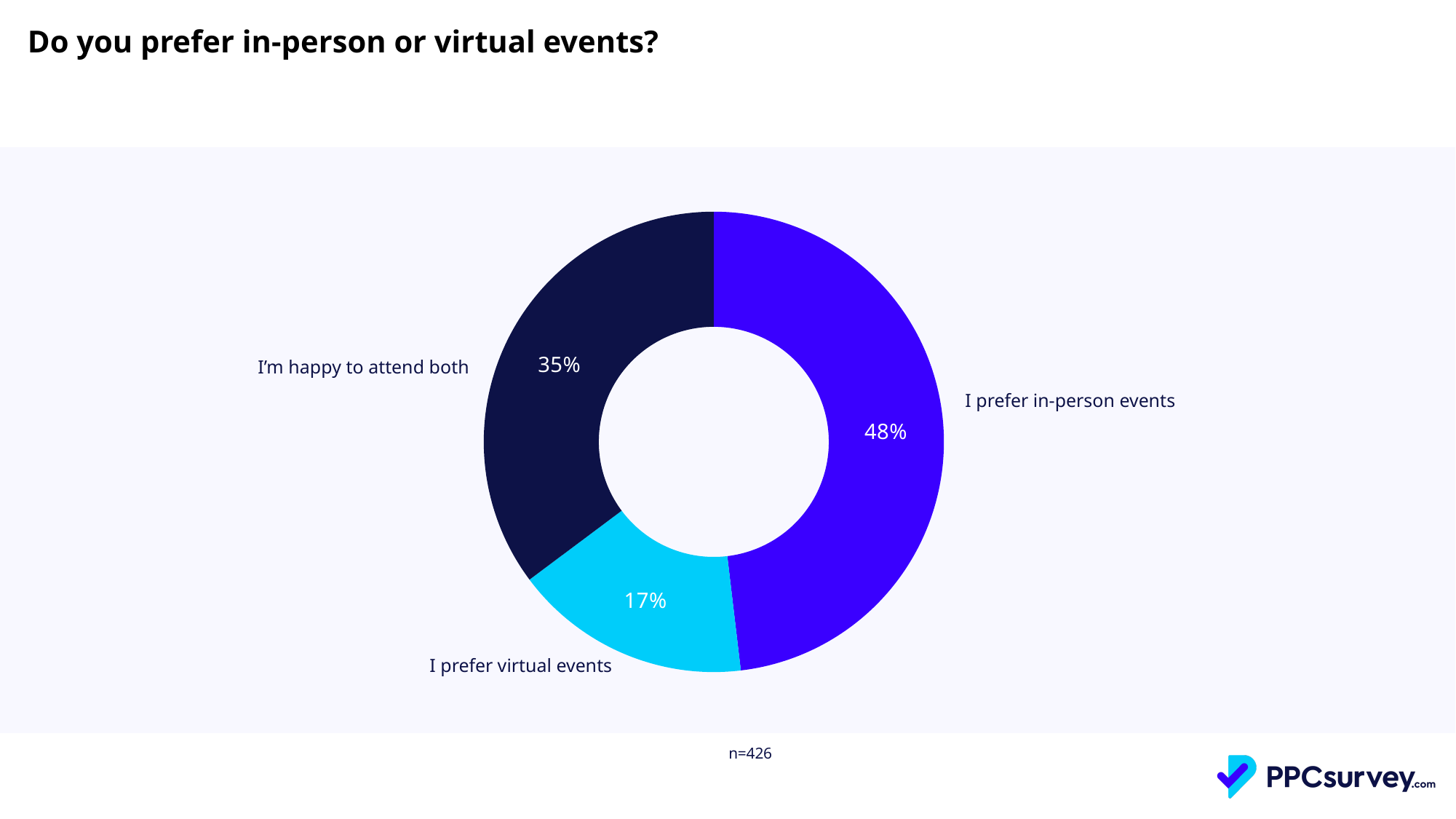
What percentage of respondents are happy to attend both? 35% Which response has the largest share? I prefer in-person events What is the difference in percentage points between 'I prefer in-person events' and 'I prefer virtual events'? 31 How many response categories are shown in the chart? 3 What kind of chart is shown on the slide? Pie chart (donut) What percentage of respondents prefer in-person events? 48% What is the difference in percentage points between 'I prefer in-person events' and 'I'm happy to attend both'? 13 Which is larger: the share for 'I'm happy to attend both' or 'I prefer virtual events'? I'm happy to attend both What is the title of the chart? Do you prefer in-person or virtual events? Which response has the smallest share? I prefer virtual events What percentage of respondents prefer virtual events? 17% How many respondents (n) does the chart report? n=426